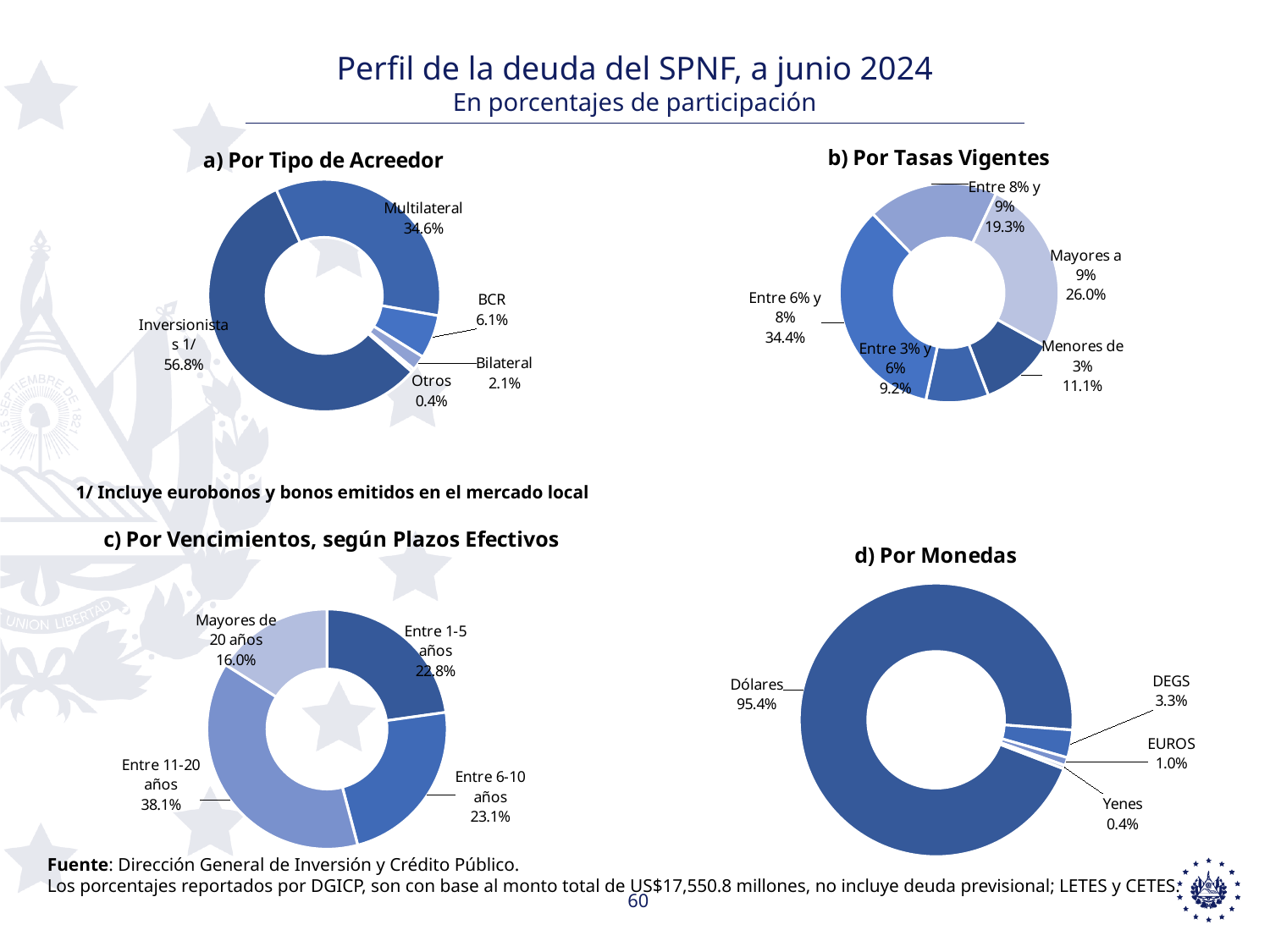
In chart c) Por Vencimientos, según Plazos Efectivos, how many categories are shown? 4 In chart a) Por Tipo de Acreedor, what share corresponds to Multilateral? 34.6% In chart a) Por Tipo de Acreedor, which category has the smallest share? Otros In chart a) Por Tipo de Acreedor, which category has the largest share? Inversionistas 1/ What type of chart is used in d) Por Monedas? Donut (pie) chart In chart d) Por Monedas, what share corresponds to Dólares? 95.4% In chart d) Por Monedas, what is the difference between the shares of DEGS and EUROS? 2.3% In chart b) Por Tasas Vigentes, what is the difference between the shares of Mayores a 9% and Menores de 3%? 14.9% In chart c) Por Vencimientos, según Plazos Efectivos, what share corresponds to Entre 11-20 años? 38.1% In chart c) Por Vencimientos, según Plazos Efectivos, which is larger: Entre 1-5 años or Mayores de 20 años? Entre 1-5 años In chart b) Por Tasas Vigentes, what share corresponds to Entre 6% y 8%? 34.4% In chart b) Por Tasas Vigentes, which category has the smallest share? Entre 3% y 6%